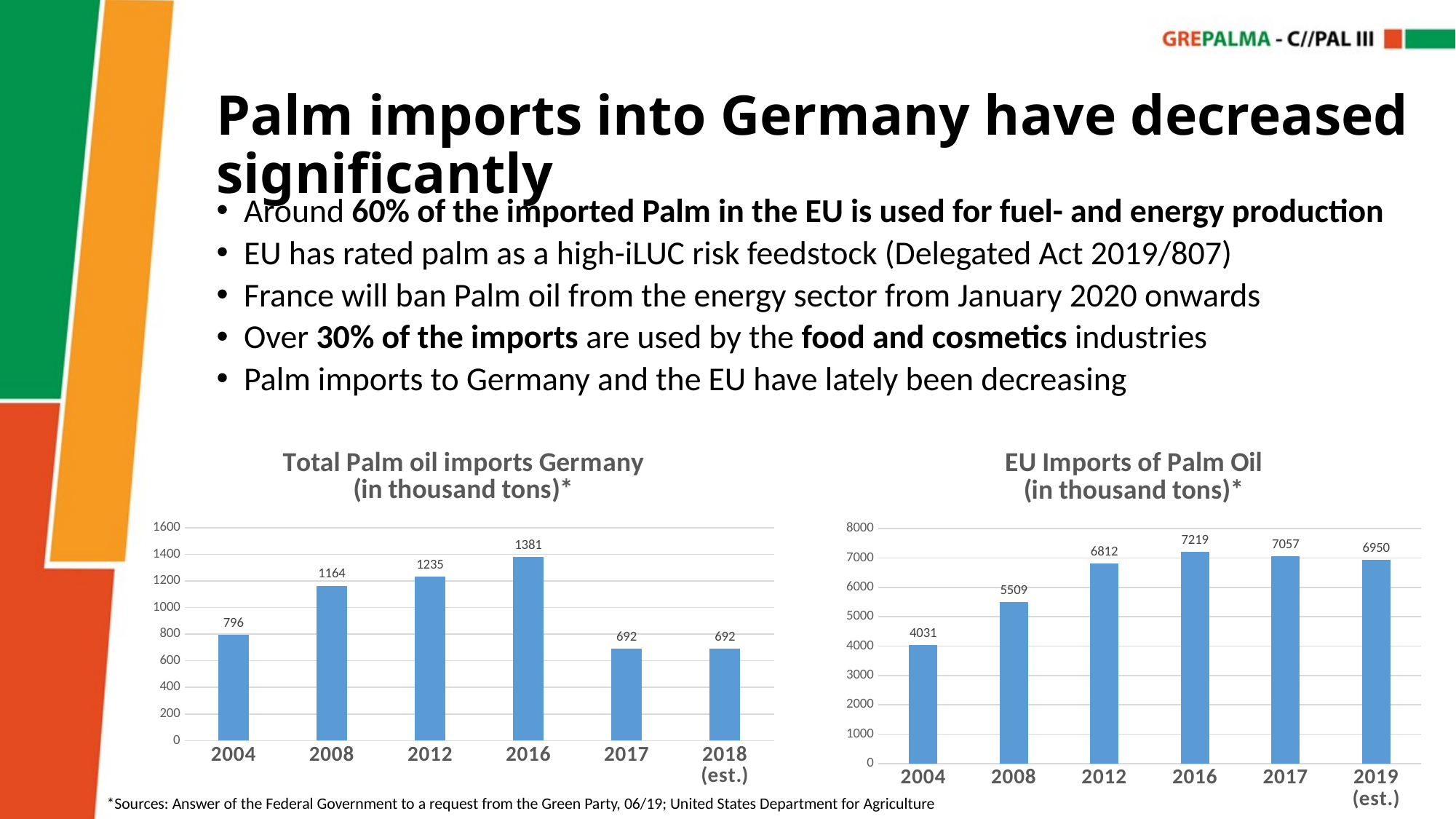
In the 'EU Imports of Palm Oil (in thousand tons)*' chart, which year has the highest value? 2016 What kind of chart is the 'EU Imports of Palm Oil (in thousand tons)*' chart? bar chart In the 'Total Palm oil imports Germany (in thousand tons)*' chart, is the value for 2004 greater or less than 1000? less In the 'EU Imports of Palm Oil (in thousand tons)*' chart, what is the value for 2008? 5509 In the 'Total Palm oil imports Germany (in thousand tons)*' chart, what is the value for 2016? 1381 In the 'EU Imports of Palm Oil (in thousand tons)*' chart, what is the difference between the 2016 and 2019 (est.) values? 269 In the 'EU Imports of Palm Oil (in thousand tons)*' chart, which is larger, the value for 2012 or the value for 2017? 2017 In the 'Total Palm oil imports Germany (in thousand tons)*' chart, how many years are shown on the x axis? 6 In the 'Total Palm oil imports Germany (in thousand tons)*' chart, what is the difference between the 2016 and 2017 values? 689 In the 'Total Palm oil imports Germany (in thousand tons)*' chart, which year has the lowest value? 2017 and 2018 (est.), both 692 In the 'Total Palm oil imports Germany (in thousand tons)*' chart, do the values rise or fall from 2004 to 2016? rise In the 'EU Imports of Palm Oil (in thousand tons)*' chart, which year has the lowest value? 2004